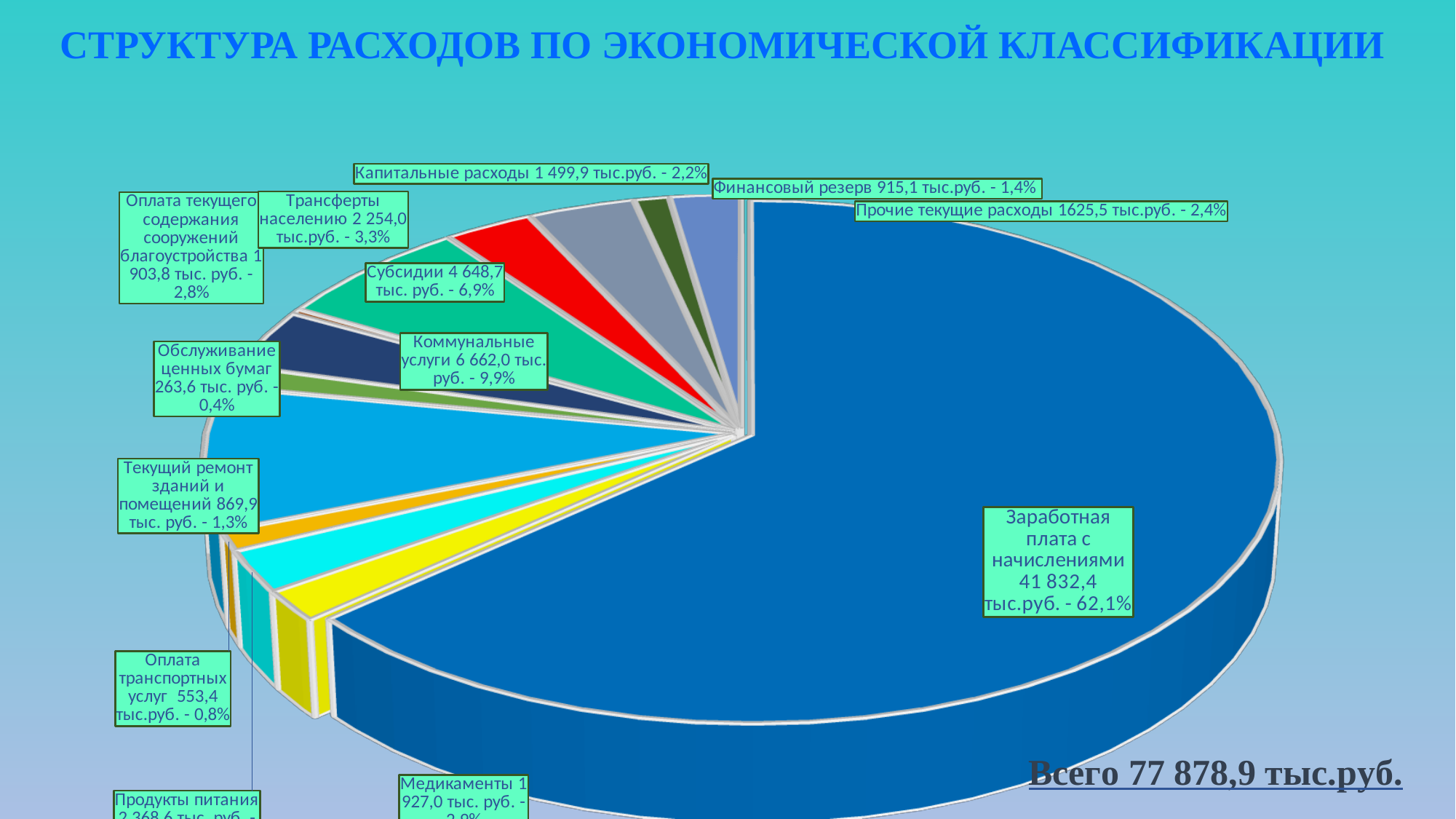
What is the difference in percentage points between "Коммунальные услуги" and "Субсидии"? 3,0% What is the amount shown for "Трансферты населению"? 2 254,0 тыс.руб. What is the title of the chart on the slide? СТРУКТУРА РАСХОДОВ ПО ЭКОНОМИЧЕСКОЙ КЛАССИФИКАЦИИ Which category has the largest share of expenses? Заработная плата с начислениями What share of expenses does "Заработная плата с начислениями" account for? 62,1% What is the amount shown for "Коммунальные услуги"? 6 662,0 тыс. руб. What total amount of expenses is stated on the slide? 77 878,9 тыс.руб. Which labeled category has the smallest share of expenses? Обслуживание ценных бумаг What percentage is shown for "Финансовый резерв"? 1,4% What is the amount shown for "Субсидии"? 4 648,7 тыс. руб. What kind of chart is shown on the slide? pie chart Which has a larger share: "Капитальные расходы" or "Прочие текущие расходы"? Прочие текущие расходы